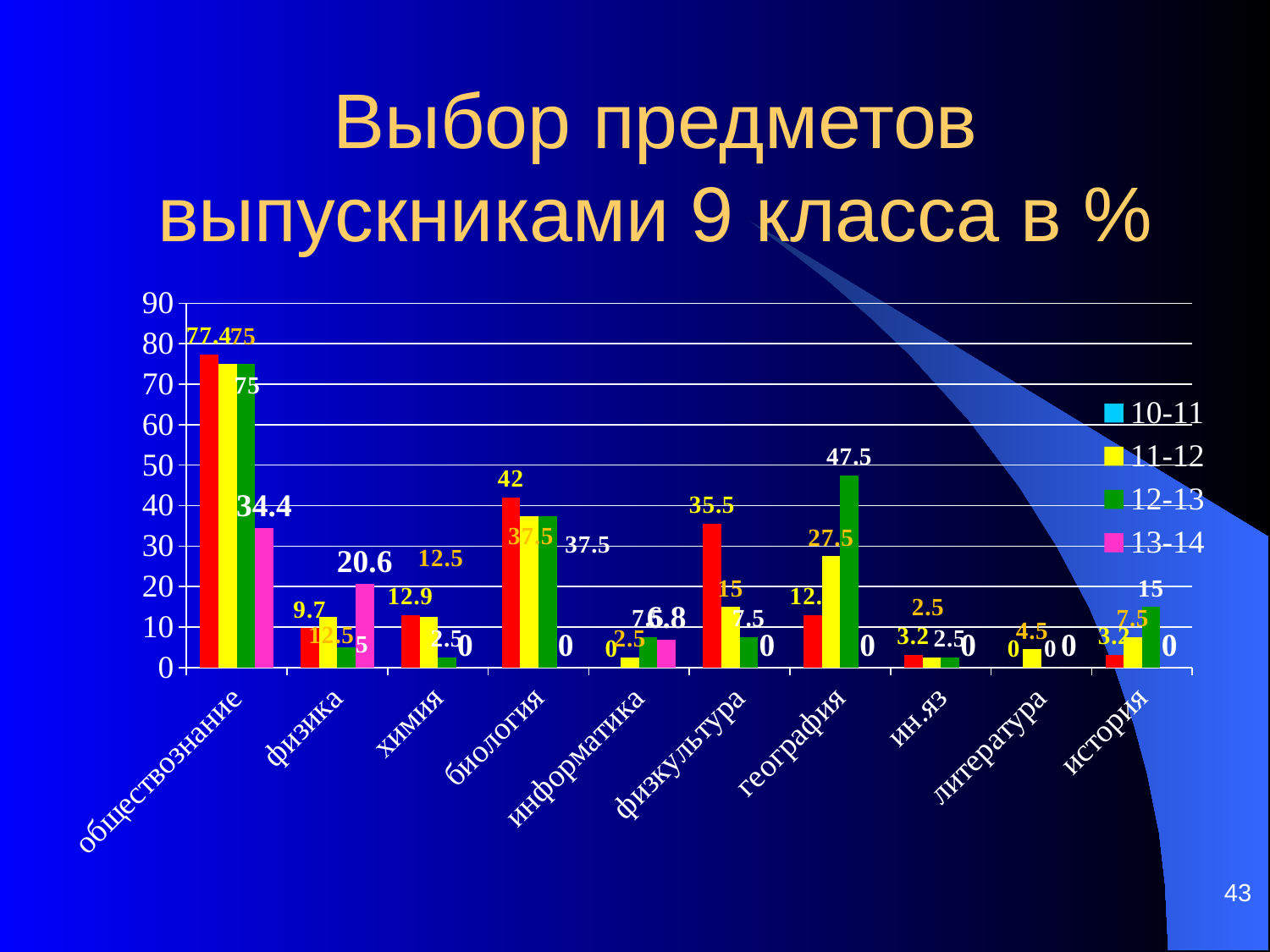
What kind of chart is shown on the slide? bar chart Which subject has the highest value in the 12-13 series? обществознание How many series does the legend list? 4 What is the value for литература in the 11-12 series? 4.5 How many subject categories are shown on the x axis? 10 What is the difference between the 11-12 value and the 13-14 value for обществознание? 40.6 Which subject has the lowest value in the 12-13 series? литература What is the value for география in the 12-13 series? 47.5 What is the value for физика in the 13-14 series? 20.6 What is the value for физкультура in the 11-12 series? 15 In the 11-12 series, which is larger: биология or физкультура? биология What is the value for обществознание in the 13-14 series? 34.4